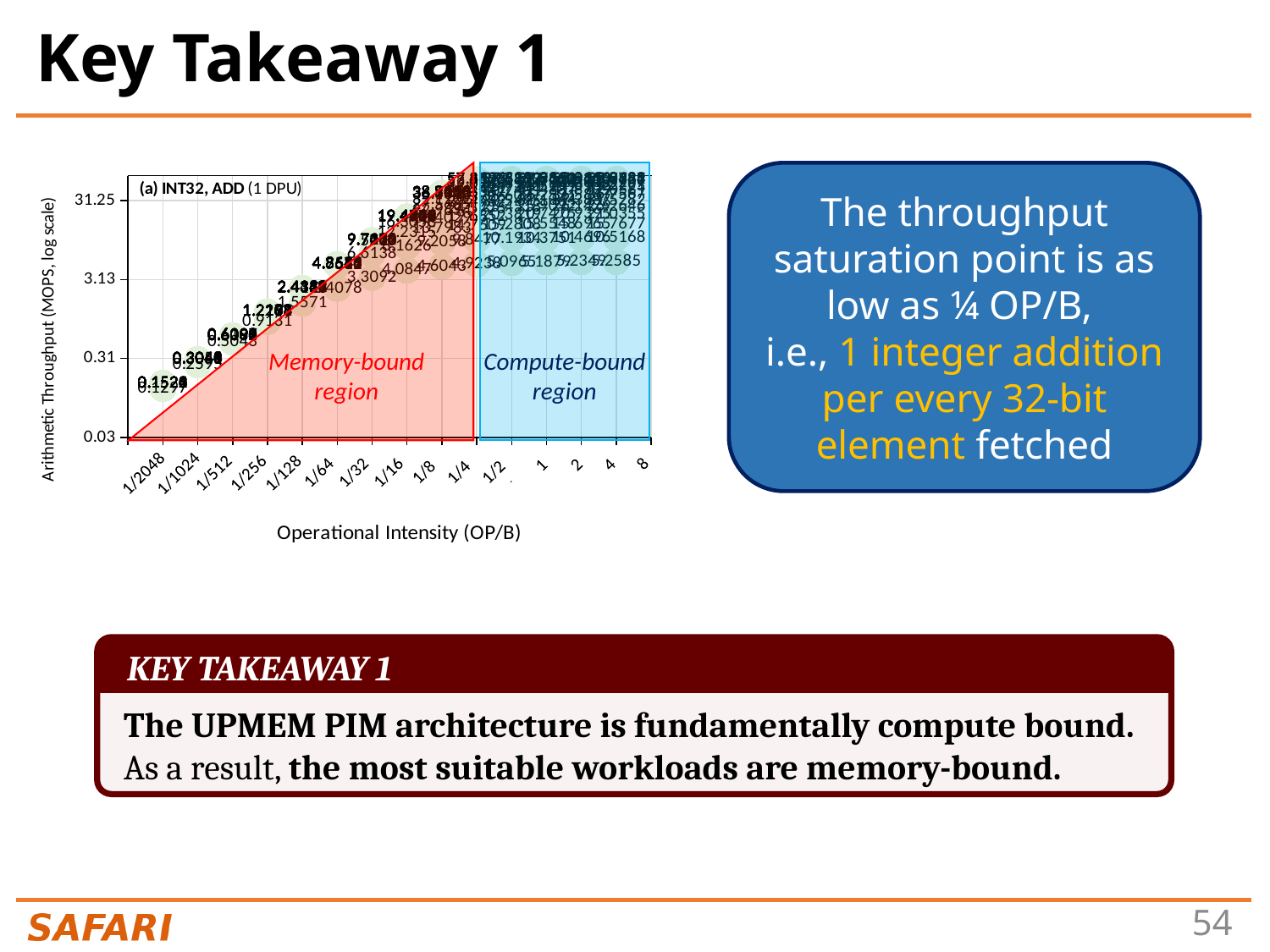
What is the label of the x axis of the chart? Operational Intensity (OP/B) Which operational intensity has the lowest arithmetic throughput in the chart? 1/2048 Which has the higher arithmetic throughput: operational intensity 1/128 or 1/16? 1/16 Is the arithmetic throughput at operational intensity 1/256 greater or less than 3.13 MOPS? less What are the names of the two shaded regions in the chart? Memory-bound region and Compute-bound region How many operational intensity values are marked on the x axis of the chart? 15 As operational intensity increases from 1/2048 to 1/4, does the arithmetic throughput rise or fall? rise Is the arithmetic throughput at operational intensity 1/32 greater or less than 3.13 MOPS? greater Which has the higher arithmetic throughput: operational intensity 1/2048 or 1/4? 1/4 What kind of chart is shown on the slide? scatter chart Is the arithmetic throughput at operational intensity 1/2048 greater or less than 0.31 MOPS? less